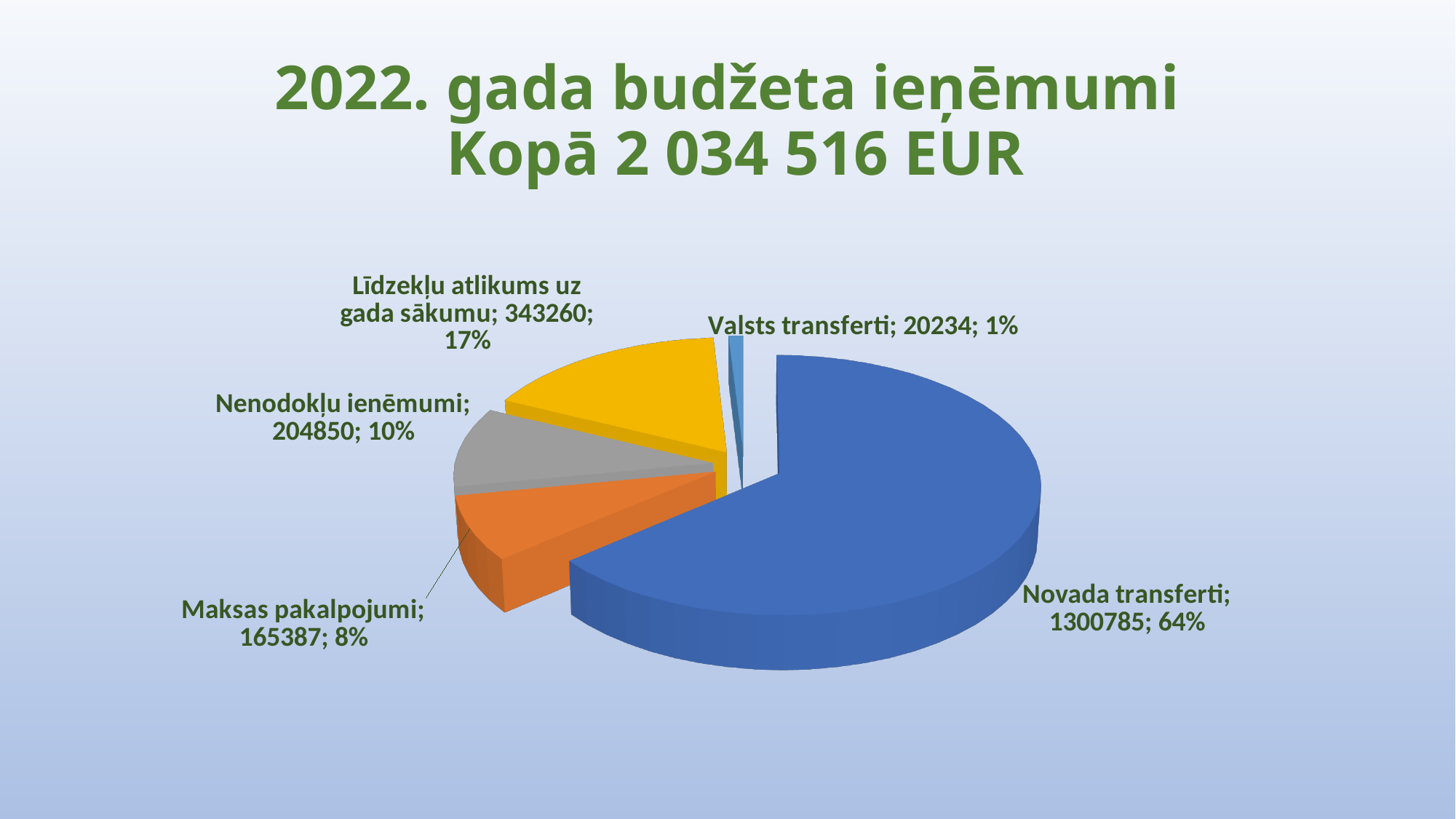
What share of the pie does Maksas pakalpojumi represent? 8% What is the value for Novada transferti? 1300785 Which category has the smallest slice? Valsts transferti What kind of chart is shown on the slide? Pie chart What is the difference between the values for Līdzekļu atlikums uz gada sākumu and Nenodokļu ienēmumi? 138410 What is the value for Valsts transferti? 20234 Which category has the largest slice? Novada transferti What is the value for Nenodokļu ienēmumi? 204850 How many categories are shown in the pie chart? 5 Which is larger, Nenodokļu ienēmumi or Maksas pakalpojumi? Nenodokļu ienēmumi What share of the pie does Novada transferti represent? 64% What is the value for Līdzekļu atlikums uz gada sākumu? 343260